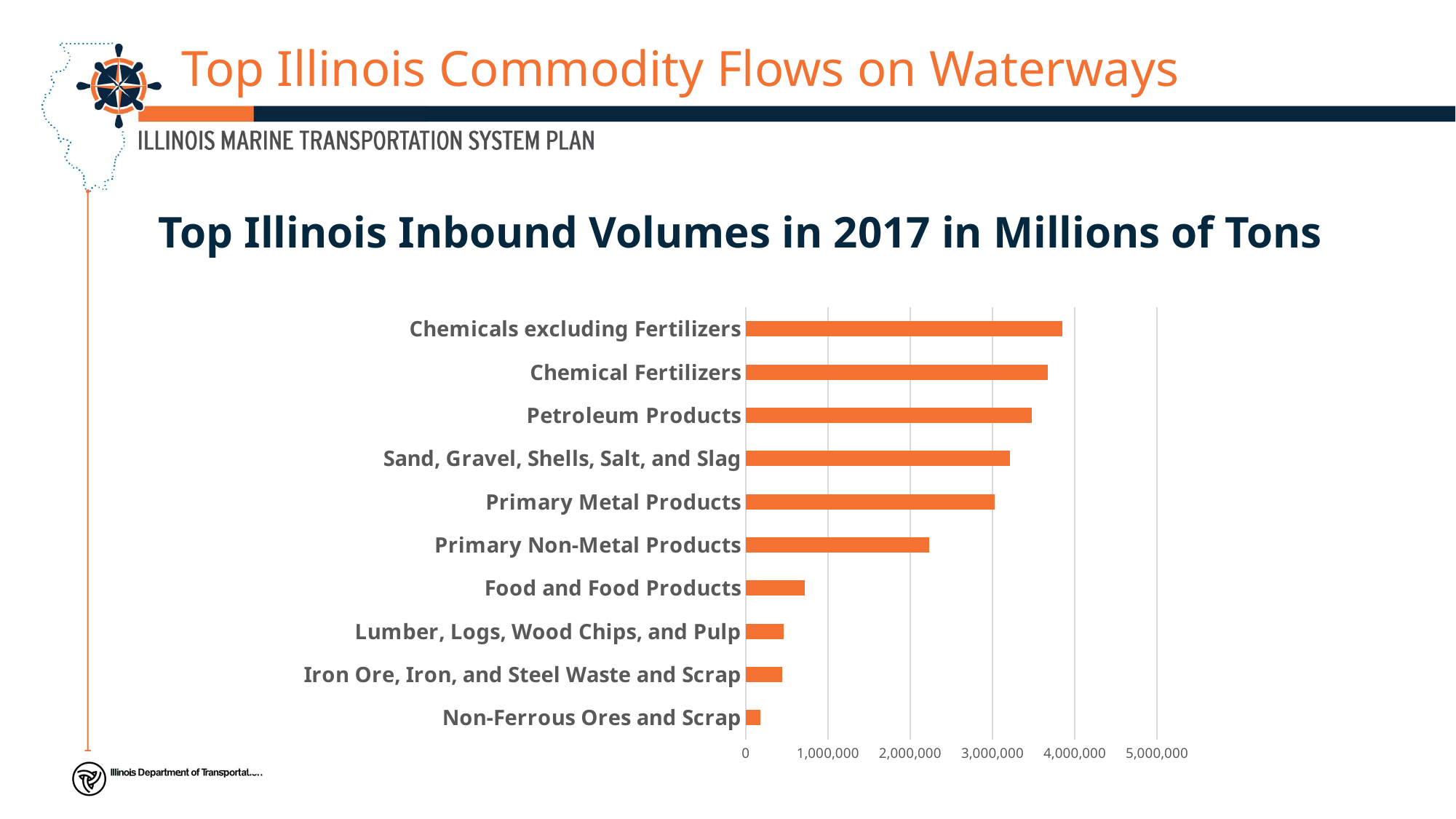
Which commodity category has the lowest inbound volume? Non-Ferrous Ores and Scrap Which is larger, the value for Petroleum Products or the value for Sand, Gravel, Shells, Salt, and Slag? Petroleum Products What kind of chart is shown on the slide? Bar chart Which is larger, the value for Primary Metal Products or the value for Primary Non-Metal Products? Primary Metal Products Is the value for Food and Food Products greater or less than 1,000,000? less What is the title of the chart? Top Illinois Inbound Volumes in 2017 in Millions of Tons Is the value for Chemical Fertilizers greater or less than 4,000,000? less Is the value for Chemicals excluding Fertilizers greater or less than 3,000,000? greater What colour are the bars in the chart? Orange How many commodity categories are plotted in the chart? 10 Which commodity category has the highest inbound volume? Chemicals excluding Fertilizers